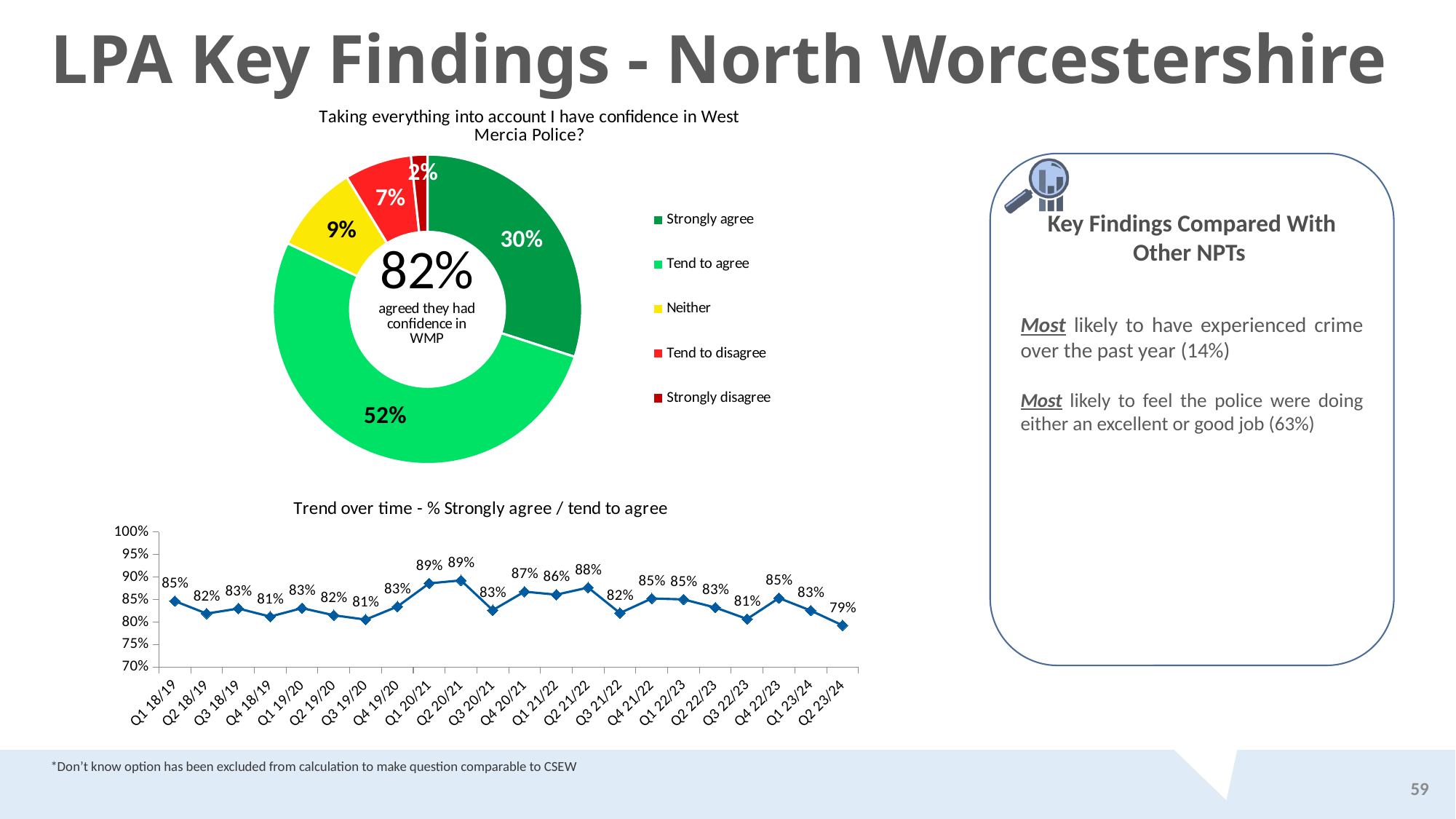
What percentage is shown in the centre of the doughnut chart 'Taking everything into account I have confidence in West Mercia Police?'? 82% In the line chart 'Trend over time - % Strongly agree / tend to agree', what is the difference between the Q1 20/21 value and the Q3 20/21 value? 6% In the doughnut chart 'Taking everything into account I have confidence in West Mercia Police?', what percentage of respondents said 'Strongly agree'? 30% In the line chart 'Trend over time - % Strongly agree / tend to agree', how many quarters are plotted on the x axis? 22 In the doughnut chart 'Taking everything into account I have confidence in West Mercia Police?', which response category has the smallest share? Strongly disagree In the line chart 'Trend over time - % Strongly agree / tend to agree', which quarter has the lowest value? Q2 23/24 In the doughnut chart 'Taking everything into account I have confidence in West Mercia Police?', what is the difference between the 'Neither' share and the 'Tend to disagree' share? 2% In the doughnut chart 'Taking everything into account I have confidence in West Mercia Police?', which response category has the largest share? Tend to agree In the line chart 'Trend over time - % Strongly agree / tend to agree', what is the value for Q2 23/24? 79% How many response categories does the legend of the doughnut chart 'Taking everything into account I have confidence in West Mercia Police?' list? 5 What kind of chart is 'Trend over time - % Strongly agree / tend to agree'? Line chart In the doughnut chart 'Taking everything into account I have confidence in West Mercia Police?', what percentage of respondents said 'Tend to agree'? 52%